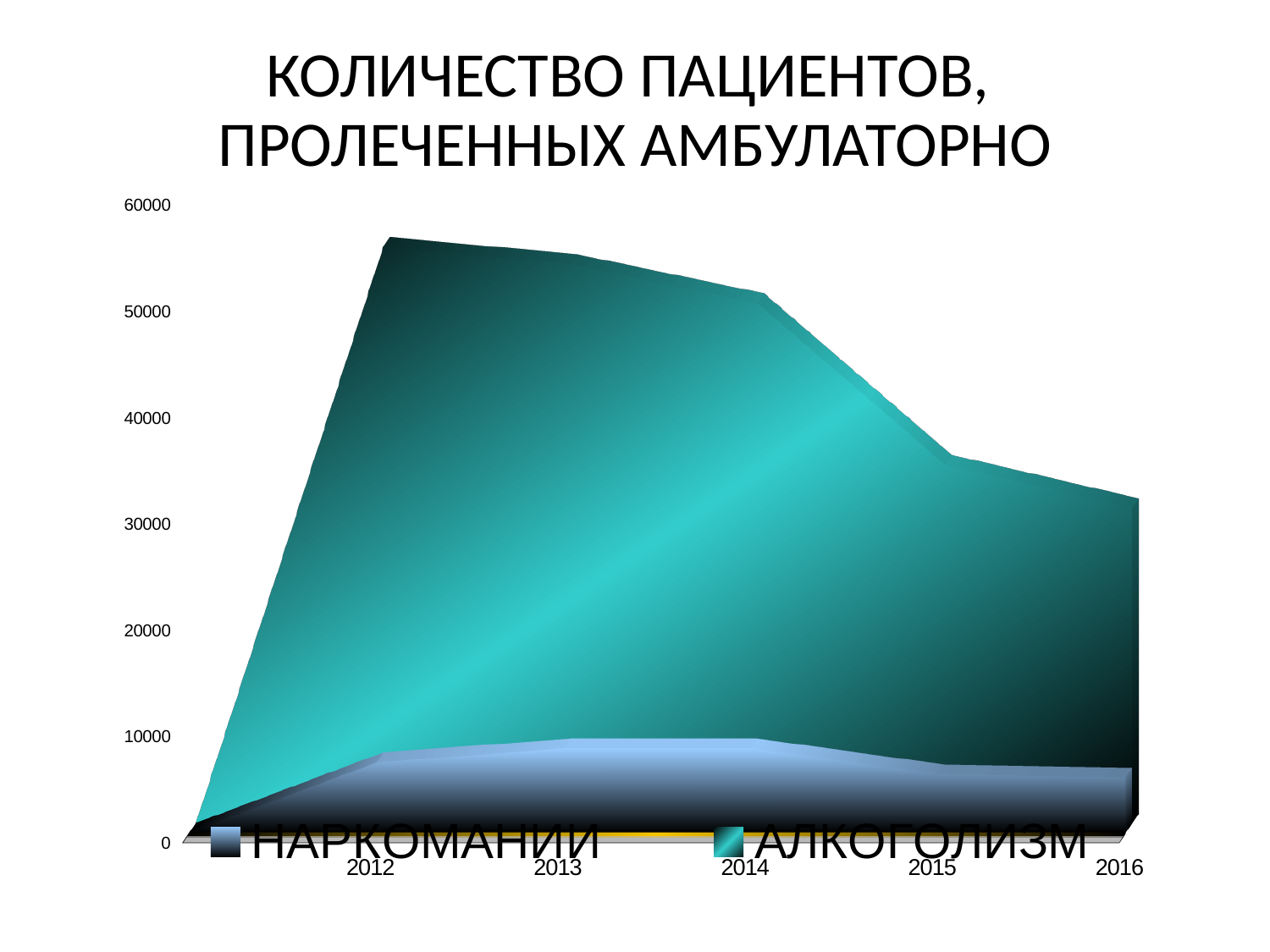
How many series does the legend list? 2 In which year is the value for АЛКОГОЛИЗМ lowest? 2016 Is the value for АЛКОГОЛИЗМ in 2015 greater or less than 40000? less Is the value for НАРКОМАНИИ in 2013 greater or less than 20000? less How many years are shown on the x axis? 5 Is the value for АЛКОГОЛИЗМ in 2012 greater or less than 50000? greater Does the value for АЛКОГОЛИЗМ rise or fall from 2012 to 2016? fall In 2014, which series has the larger value, НАРКОМАНИИ or АЛКОГОЛИЗМ? АЛКОГОЛИЗМ What is the title of the chart? КОЛИЧЕСТВО ПАЦИЕНТОВ, ПРОЛЕЧЕННЫХ АМБУЛАТОРНО In which year is the value for АЛКОГОЛИЗМ highest? 2012 What kind of chart is shown on the slide? area chart